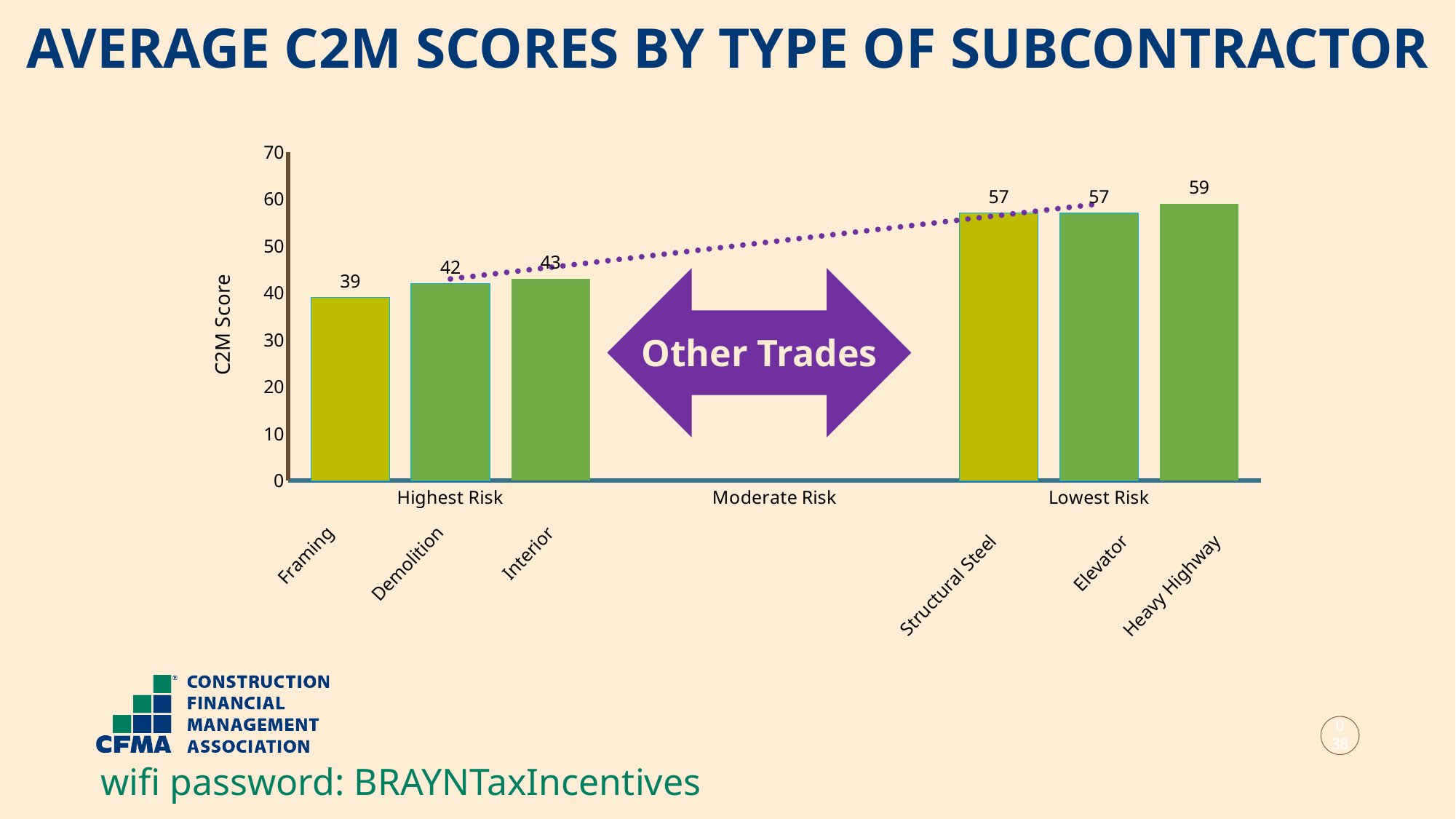
What is the difference between the C2M scores for Heavy Highway and Framing? 20 Which type of subcontractor has the lowest average C2M score? Framing How many subcontractor types have bars plotted on the chart? 6 What is the average C2M score for Framing? 39 What is the average C2M score for Interior? 43 What kind of chart is shown on the slide? Bar chart What is the label on the vertical axis of the chart? C2M Score Is the value for Structural Steel greater or less than 50? greater Which has a higher C2M score, Interior or Elevator? Elevator What is the average C2M score for Demolition? 42 Which type of subcontractor has the highest average C2M score? Heavy Highway What is the average C2M score for Heavy Highway? 59